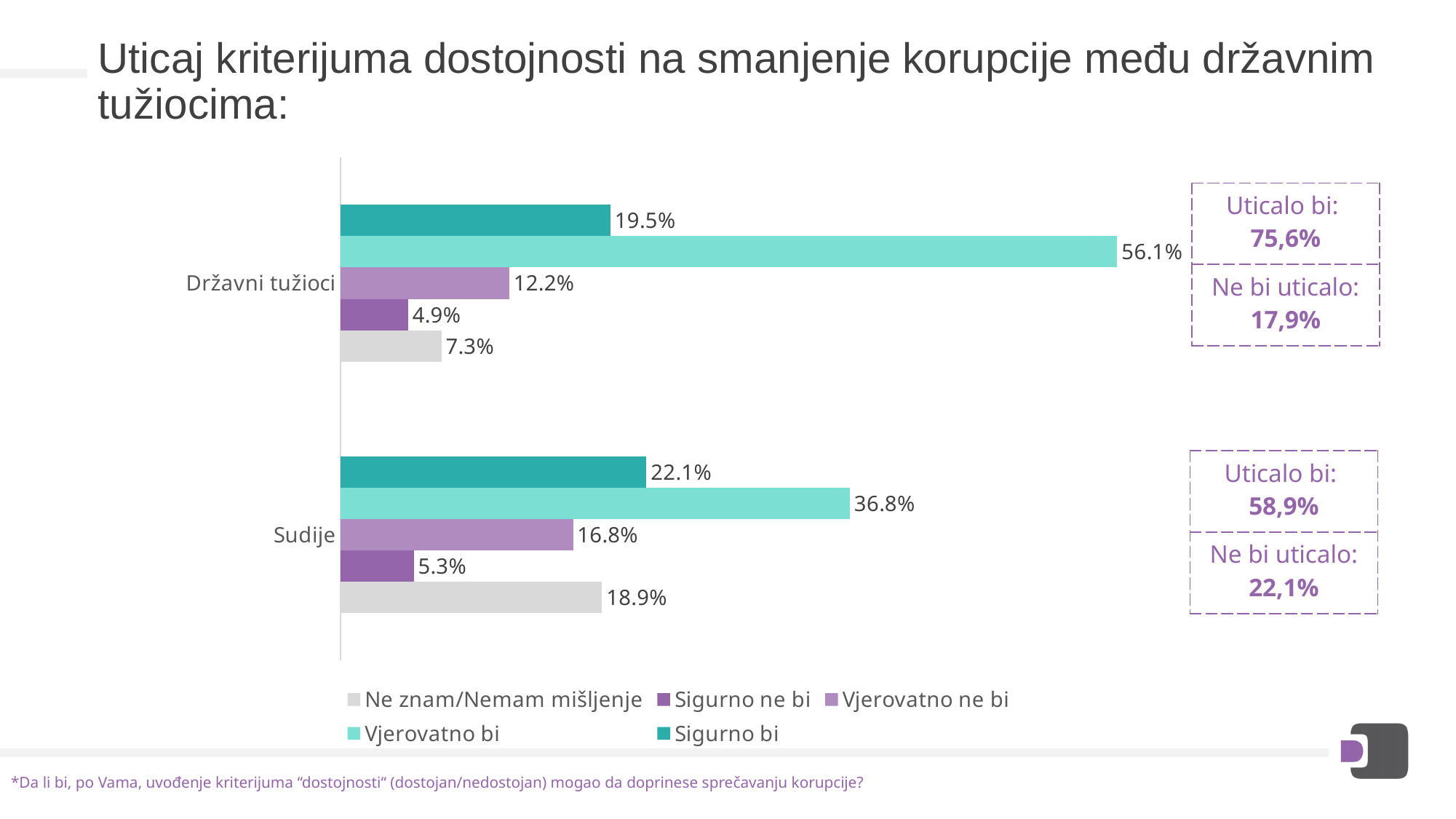
Which series has the highest value for Sudije? Vjerovatno bi How many series does the legend list? 5 What kind of chart is shown on the slide? Bar chart Which series is shown in light grey in the legend? Ne znam/Nemam mišljenje What is the value of "Ne znam/Nemam mišljenje" for Sudije? 18.9% What is the value of "Sigurno bi" for Sudije? 22.1% Which series has the lowest value for Državni tužioci? Sigurno ne bi What is the value of "Sigurno ne bi" for Državni tužioci? 4.9% Which is larger: "Vjerovatno ne bi" for Državni tužioci or "Vjerovatno ne bi" for Sudije? Sudije What is the value of "Vjerovatno bi" for Državni tužioci? 56.1% What is the difference between the "Vjerovatno bi" values for Državni tužioci and Sudije? 19.3% How many categories are shown on the chart? 2